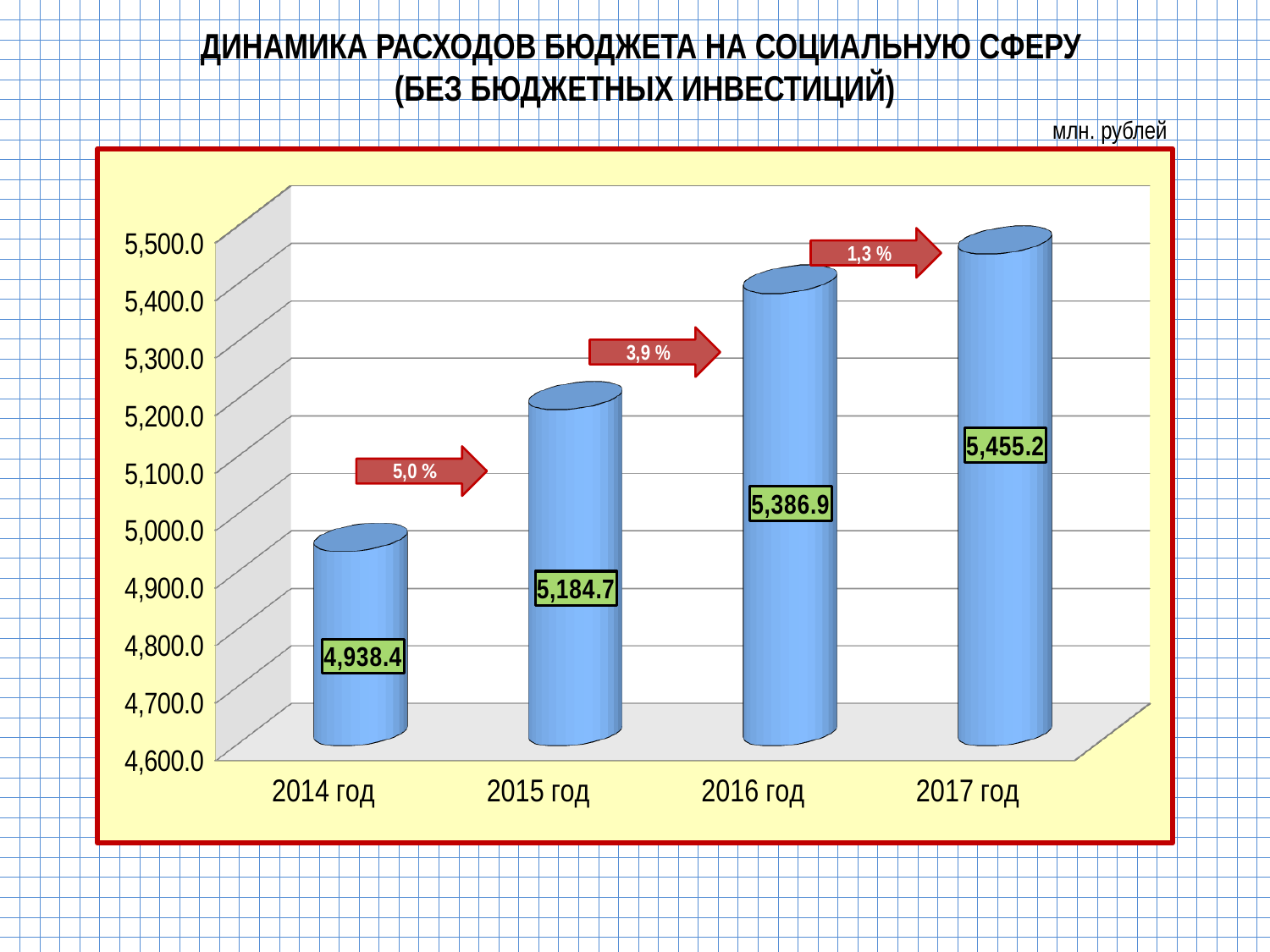
What is the value for 2014 год? 4,938.4 What kind of chart is shown on the slide? bar chart What is the value for 2017 год? 5,455.2 Which year has the highest value? 2017 год Which year has the lowest value? 2014 год What is the difference between the values for 2015 год and 2014 год? 246.3 How many years are shown on the chart? 4 What is the difference between the values for 2017 год and 2016 год? 68.3 Is the value for 2015 год greater or less than 5,100.0? greater What percentage growth is shown by the arrow between 2015 год and 2016 год? 3,9 % Which is larger, the value for 2015 год or the value for 2016 год? 2016 год What is the value for 2016 год? 5,386.9